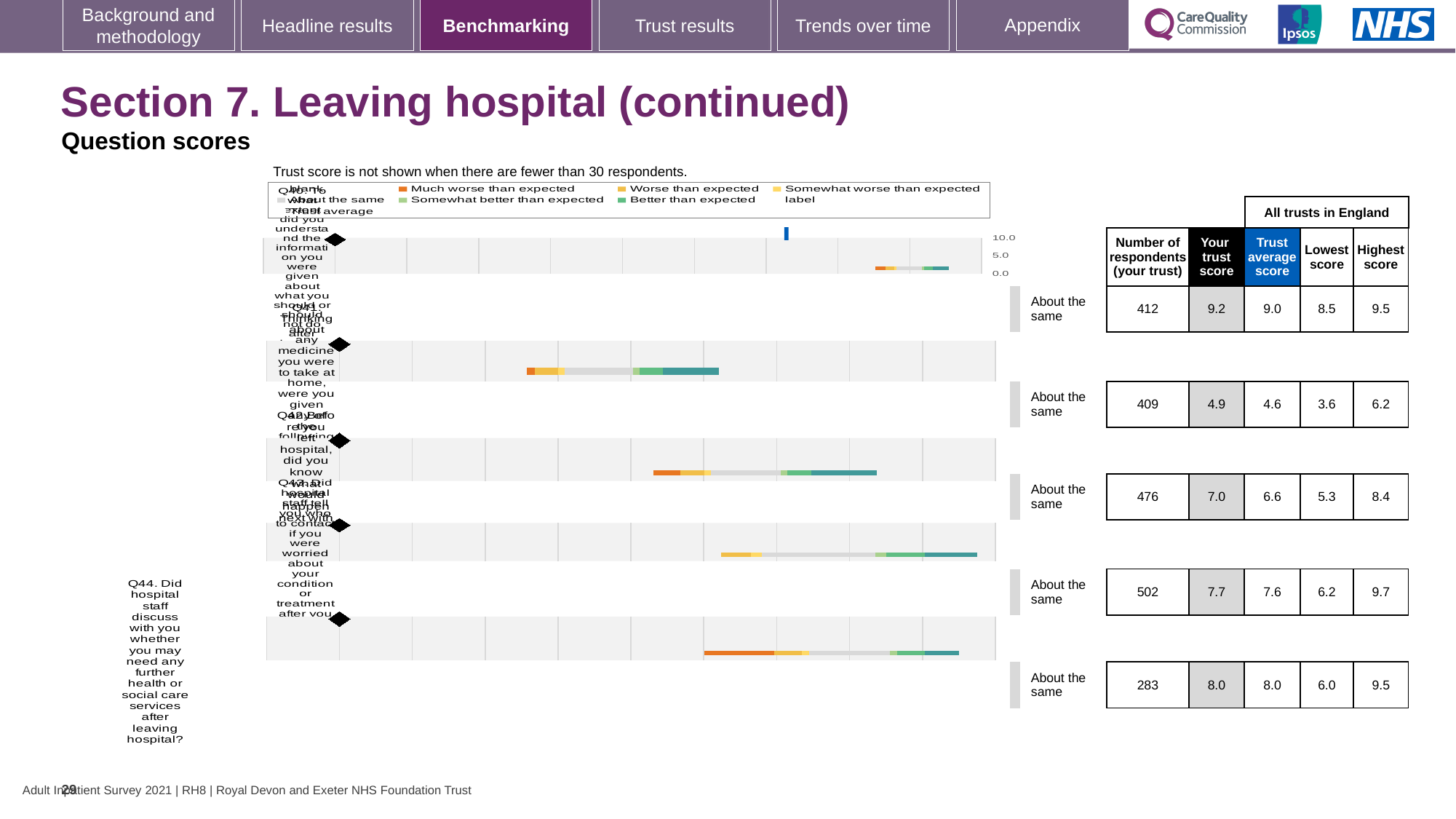
Which legend entry is shown in orange? Much worse than expected What is the highest value shown on the chart's axis? 10.0 What is the difference between the highest score and the lowest score for Q44? 3.5 What is the lowest score across all trusts in England for Q44? 6.0 What is the number of respondents for Q44? 283 Is the trust score for Q44 greater or less than 5.0? greater What is the trust score for Q44 (Did hospital staff discuss with you whether you may need any further health or social care services after leaving hospital?)? 8.0 What is the highest score across all trusts in England for Q44? 9.5 What kind of chart is shown on the slide? bar chart How many question rows (bars) does the chart show? 5 How many of the question rows are rated 'About the same'? 5